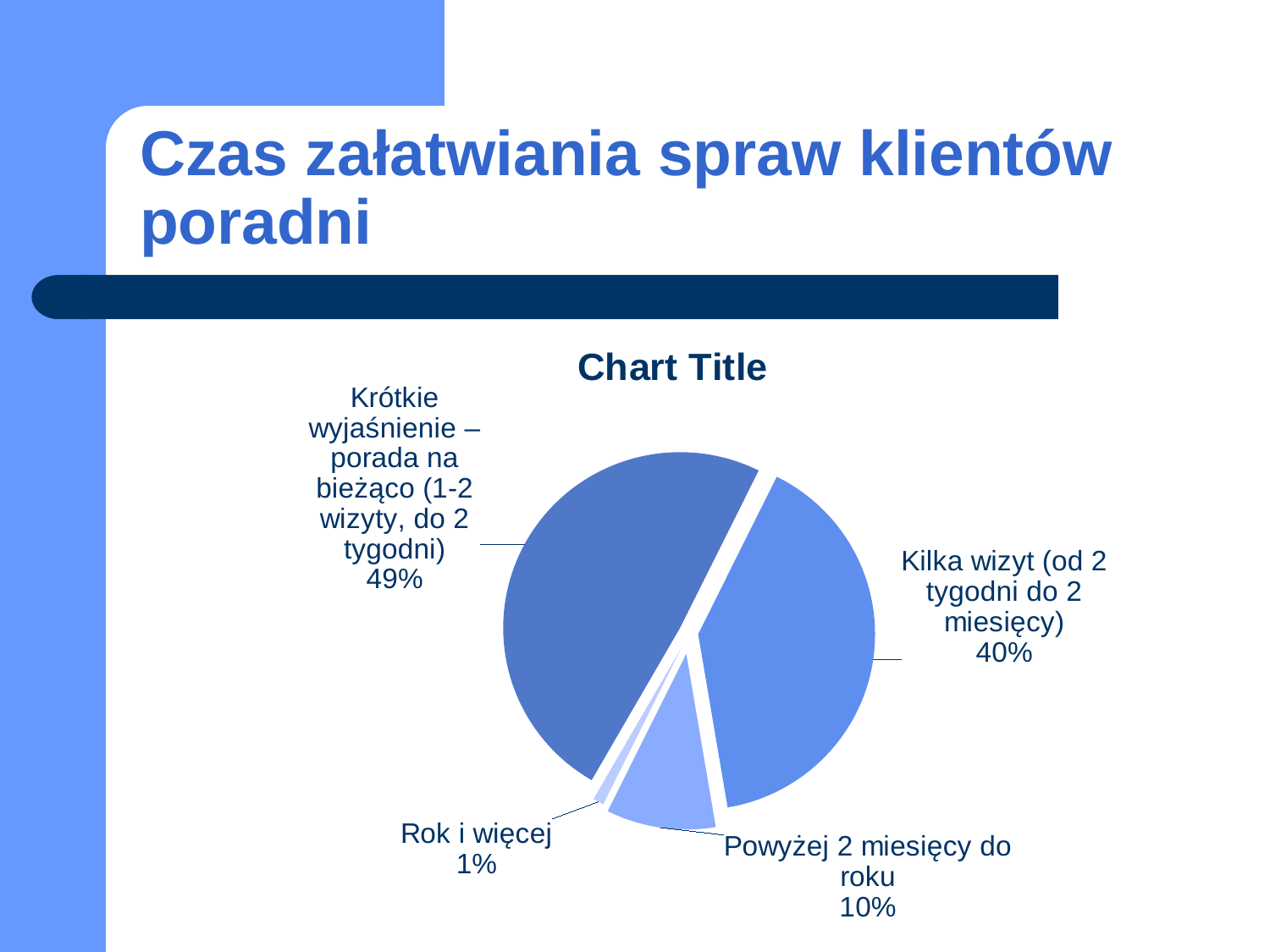
Which category has the largest slice of the pie? Krótkie wyjaśnienie – porada na bieżąco (1-2 wizyty, do 2 tygodni) Which category has the smallest slice of the pie? Rok i więcej Which is larger: 'Kilka wizyt (od 2 tygodni do 2 miesięcy)' or 'Powyżej 2 miesięcy do roku'? Kilka wizyt (od 2 tygodni do 2 miesięcy) What share of the pie does 'Krótkie wyjaśnienie – porada na bieżąco (1-2 wizyty, do 2 tygodni)' represent? 49% What is the difference in percentage points between 'Krótkie wyjaśnienie – porada na bieżąco (1-2 wizyty, do 2 tygodni)' and 'Kilka wizyt (od 2 tygodni do 2 miesięcy)'? 9 percentage points What is the value shown for 'Powyżej 2 miesięcy do roku'? 10% What is the difference in percentage points between 'Powyżej 2 miesięcy do roku' and 'Rok i więcej'? 9 percentage points How many slices does the pie chart have? 4 What type of chart is shown on the slide? pie chart What is the value shown for 'Rok i więcej'? 1% What is the title printed above the pie chart? Chart Title What share of the pie does 'Kilka wizyt (od 2 tygodni do 2 miesięcy)' represent? 40%